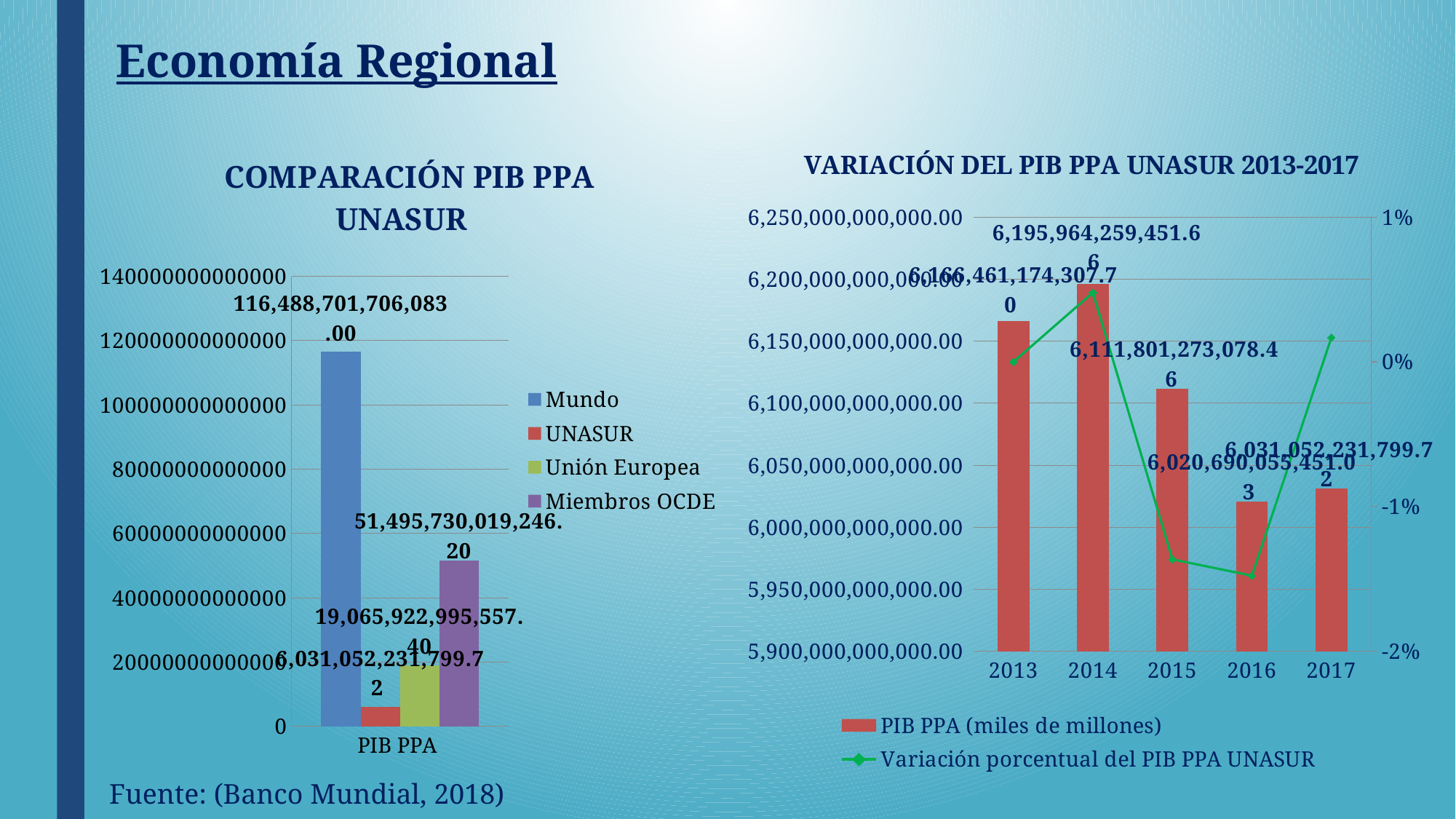
In the chart titled 'VARIACIÓN DEL PIB PPA UNASUR 2013-2017', which year has the lowest PIB PPA bar? 2016 In the chart titled 'COMPARACIÓN PIB PPA UNASUR', which series has the highest value? Mundo In the chart titled 'VARIACIÓN DEL PIB PPA UNASUR 2013-2017', what colour is the line for 'Variación porcentual del PIB PPA UNASUR'? green In the chart titled 'VARIACIÓN DEL PIB PPA UNASUR 2013-2017', what is the PIB PPA value for 2016? 6,020,690,055,451.03 In the chart titled 'VARIACIÓN DEL PIB PPA UNASUR 2013-2017', what is the PIB PPA value for 2014? 6,195,964,259,451.66 In the chart titled 'COMPARACIÓN PIB PPA UNASUR', which series has the lowest value? UNASUR In the chart titled 'COMPARACIÓN PIB PPA UNASUR', what is the value for Miembros OCDE? 51,495,730,019,246.20 In the chart titled 'VARIACIÓN DEL PIB PPA UNASUR 2013-2017', how many years are shown on the x axis? 5 In the chart titled 'VARIACIÓN DEL PIB PPA UNASUR 2013-2017', which year has the highest PIB PPA bar? 2014 In the chart titled 'COMPARACIÓN PIB PPA UNASUR', how many series does the legend list? 4 In the chart titled 'COMPARACIÓN PIB PPA UNASUR', what is the value for Mundo? 116,488,701,706,083.00 In the chart titled 'COMPARACIÓN PIB PPA UNASUR', is the value for Unión Europea larger or smaller than the value for Miembros OCDE? smaller